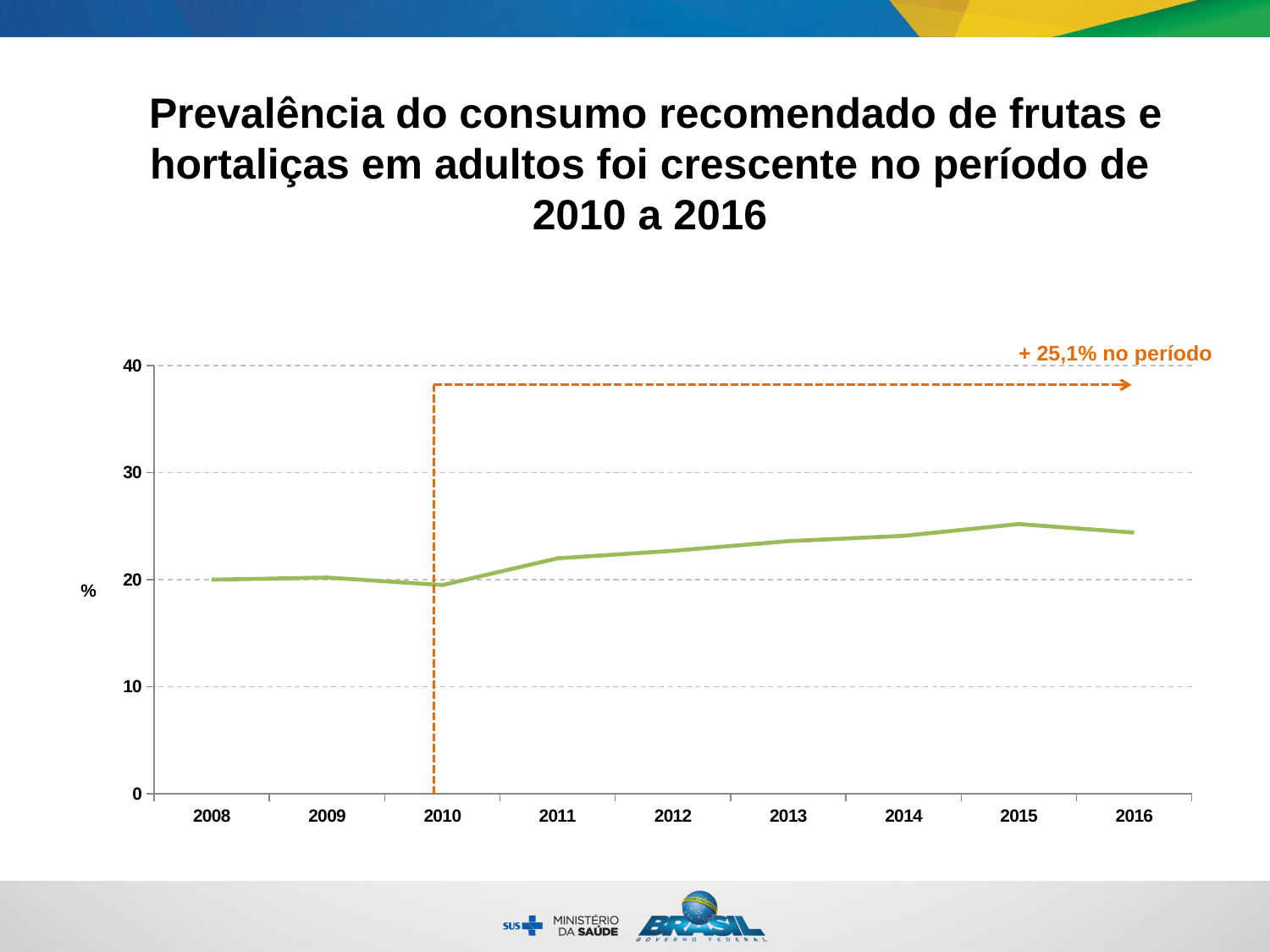
What percentage change over the period is annotated on the chart? + 25,1% no período Does the plotted value rise or fall from 2010 to 2016? rise How many years are plotted along the x axis of the chart? 9 Which year has the larger value, 2011 or 2015? 2015 Is the value for 2015 greater or less than 20? greater Is the value for 2016 greater or less than 30? less Which year has the lowest plotted value? 2010 Is the value for 2012 greater or less than 30? less What kind of chart is shown on the slide? line chart What is the label on the y axis of the chart? % Which year has the highest plotted value? 2015